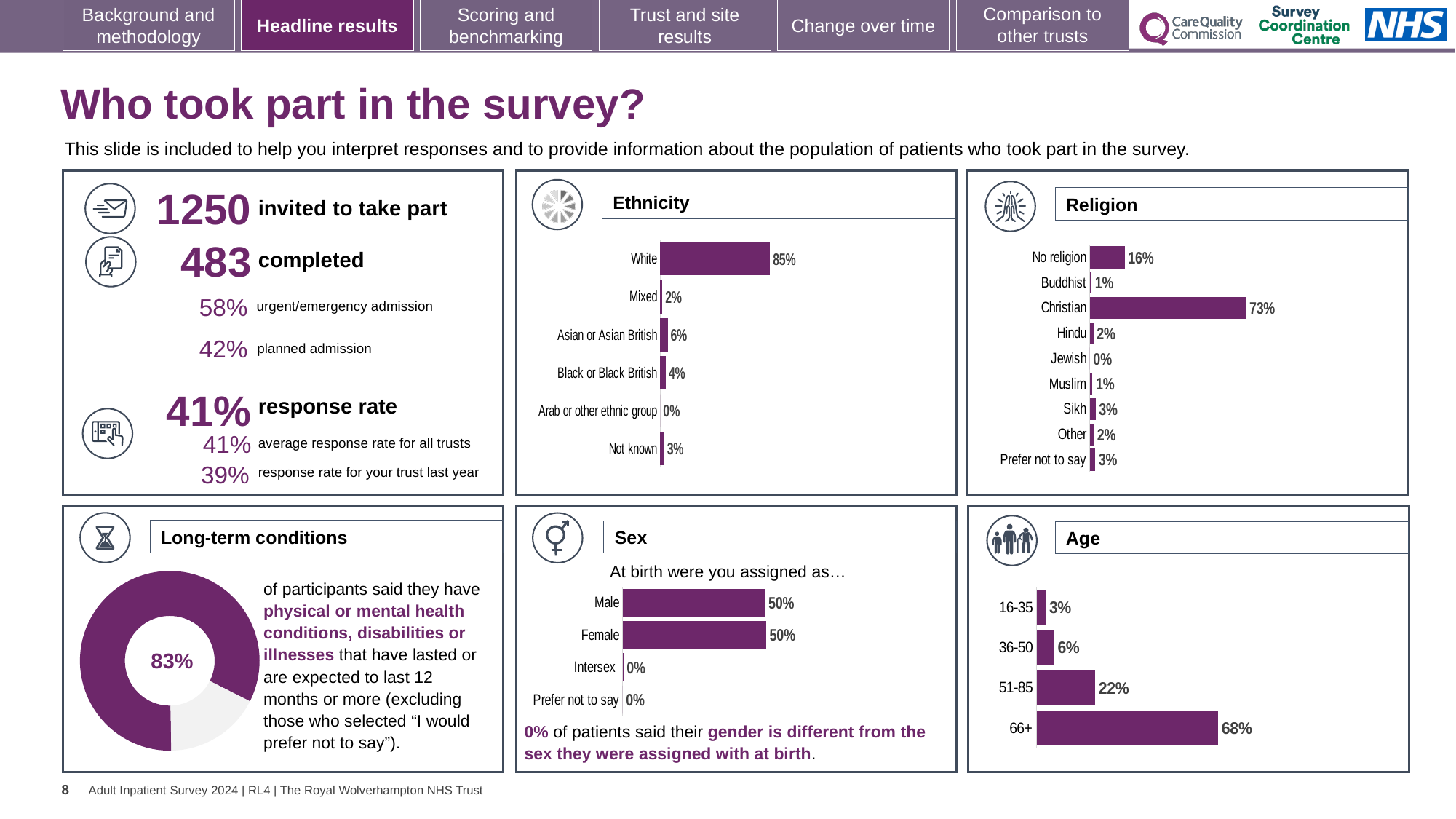
In the Religion chart, what percentage of participants were Christian? 73% What kind of chart is the Long-term conditions chart? Doughnut chart In the Sex chart, what percentage of participants were assigned Female at birth? 50% In the Ethnicity chart, how many categories are shown? 6 In the Ethnicity chart, what percentage of participants were White? 85% In the Age chart, which age group has the highest value? 66+ In the Ethnicity chart, which category has the lowest value? Arab or other ethnic group In the Age chart, what percentage of participants were aged 66+? 68% In the Religion chart, what is the difference between the Christian and No religion values? 57% In the Age chart, do the values rise or fall as you move from 16-35 to 66+? rise In the Religion chart, how many categories are shown? 9 In the Religion chart, which is larger, Sikh or Hindu? Sikh